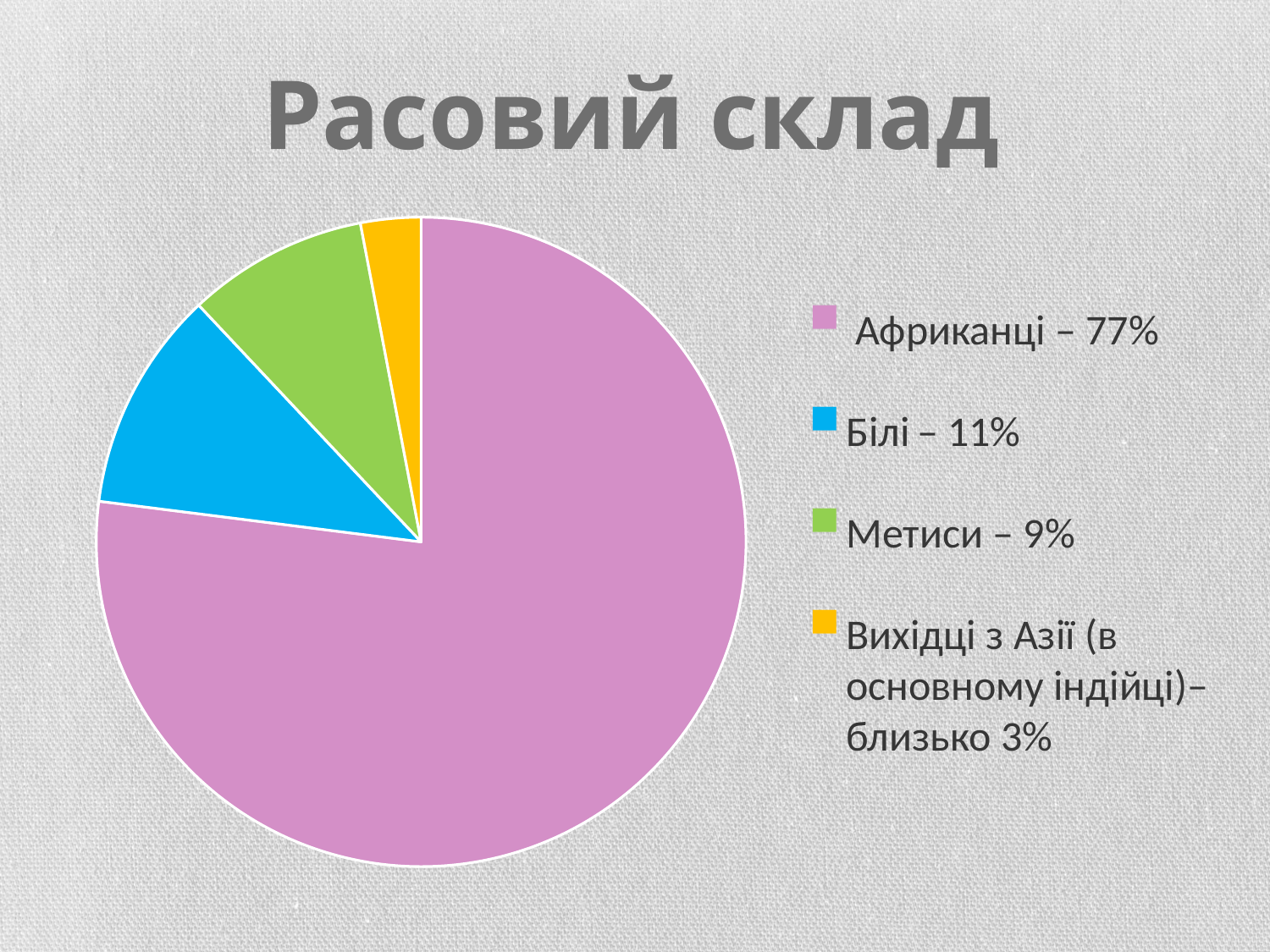
What share of the pie is Метиси? 9% What is the title of the chart? Расовий склад What is the difference between the shares for Білі and Метиси? 2% How many slices does the pie chart have? 4 What colour is the slice for Метиси? green What is the difference between the shares for Африканці and Білі? 66% What kind of chart is shown on the slide? pie chart Which category has the largest slice of the pie? Африканці Which is larger, the share for Білі or the share for Метиси? Білі What share of the pie is Білі? 11% What share of the pie is Африканці? 77% Which category has the smallest slice of the pie? Вихідці з Азії (в основному індійці)